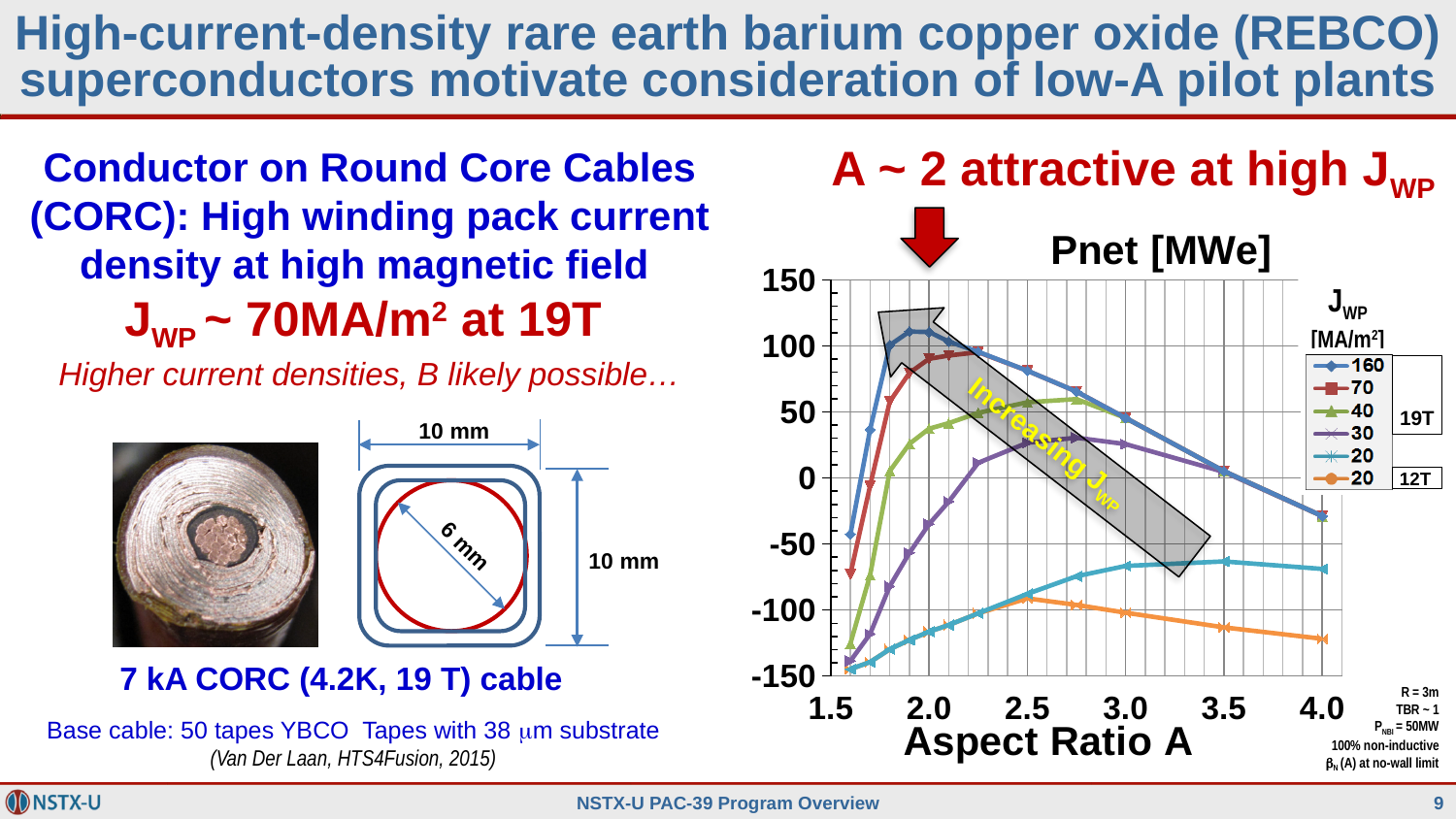
What is the title of the chart? Pnet [MWe] At aspect ratio 2.0, which series has the larger Pnet value, 160 or 70? 160 Does the 160 series rise or fall as the aspect ratio increases from 2.0 to 4.0? fall Which series reaches the highest Pnet value on the chart? 160 Is the value of the 30 series at aspect ratio 2.0 greater or less than 0? less What is the label of the x axis of the chart? Aspect Ratio A Is the value of the 160 series at aspect ratio 2.0 greater or less than 100? greater What kind of chart is shown on the slide? line chart Is the value of the 70 series at aspect ratio 2.0 greater or less than 100? less How many series does the chart legend list? 6 Which series has the lowest Pnet value at aspect ratio 4.0? 20 (12T)